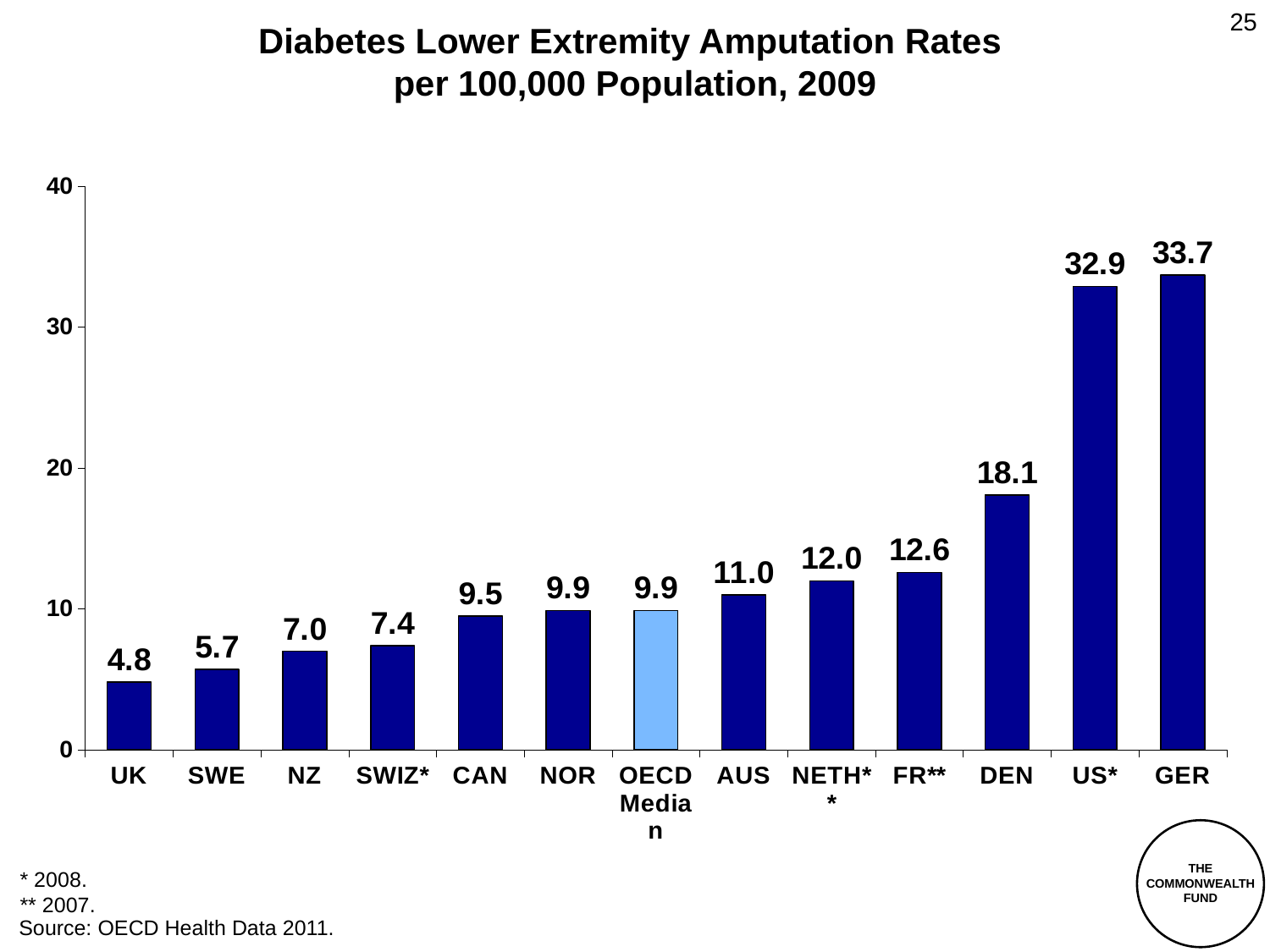
What is the diabetes lower extremity amputation rate for the UK? 4.8 What is the difference between the values for DEN and FR**? 5.5 What is the value shown for DEN? 18.1 Which country has the lowest amputation rate on the chart? UK Which country has the highest amputation rate on the chart? GER Do the values generally rise or fall from left to right along the x axis? Rise How many bars are shown on the chart? 13 What is the difference between the values for GER and US*? 0.8 Is the value for US* greater or less than 30? greater What kind of chart is shown on the slide? Bar chart Which has a higher value, AUS or CAN? AUS What is the OECD Median value shown on the chart? 9.9